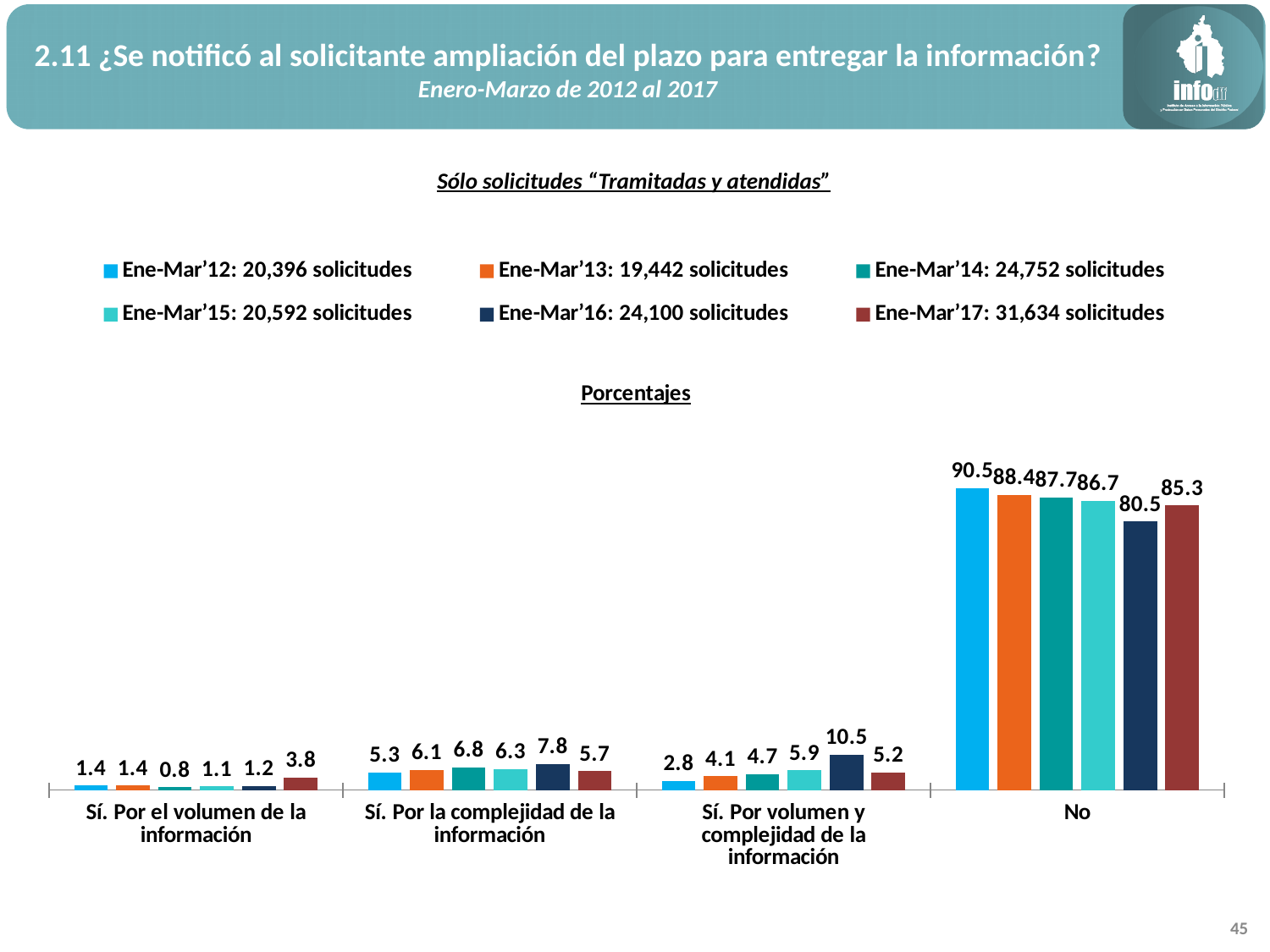
What is the value for "Sí. Por la complejidad de la información" in the Ene-Mar'14 series? 6.8 Which is larger for "Sí. Por volumen y complejidad de la información": the Ene-Mar'15 value or the Ene-Mar'17 value? Ene-Mar'15 Which series has the highest value for "Sí. Por la complejidad de la información"? Ene-Mar'16: 24,100 solicitudes What is the value for "Sí. Por el volumen de la información" in the Ene-Mar'17 series? 3.8 Which series has the lowest value for "No"? Ene-Mar'16: 24,100 solicitudes How many series does the legend list? 6 What is the value for "No" in the Ene-Mar'12 series? 90.5 What is the value for "Sí. Por volumen y complejidad de la información" in the Ene-Mar'16 series? 10.5 How many categories are shown on the x axis? 4 What is the difference between the Ene-Mar'12 and Ene-Mar'17 values for "No"? 5.2 How many solicitudes does the legend give for Ene-Mar'17? 31,634 What kind of chart is shown on the slide? bar chart